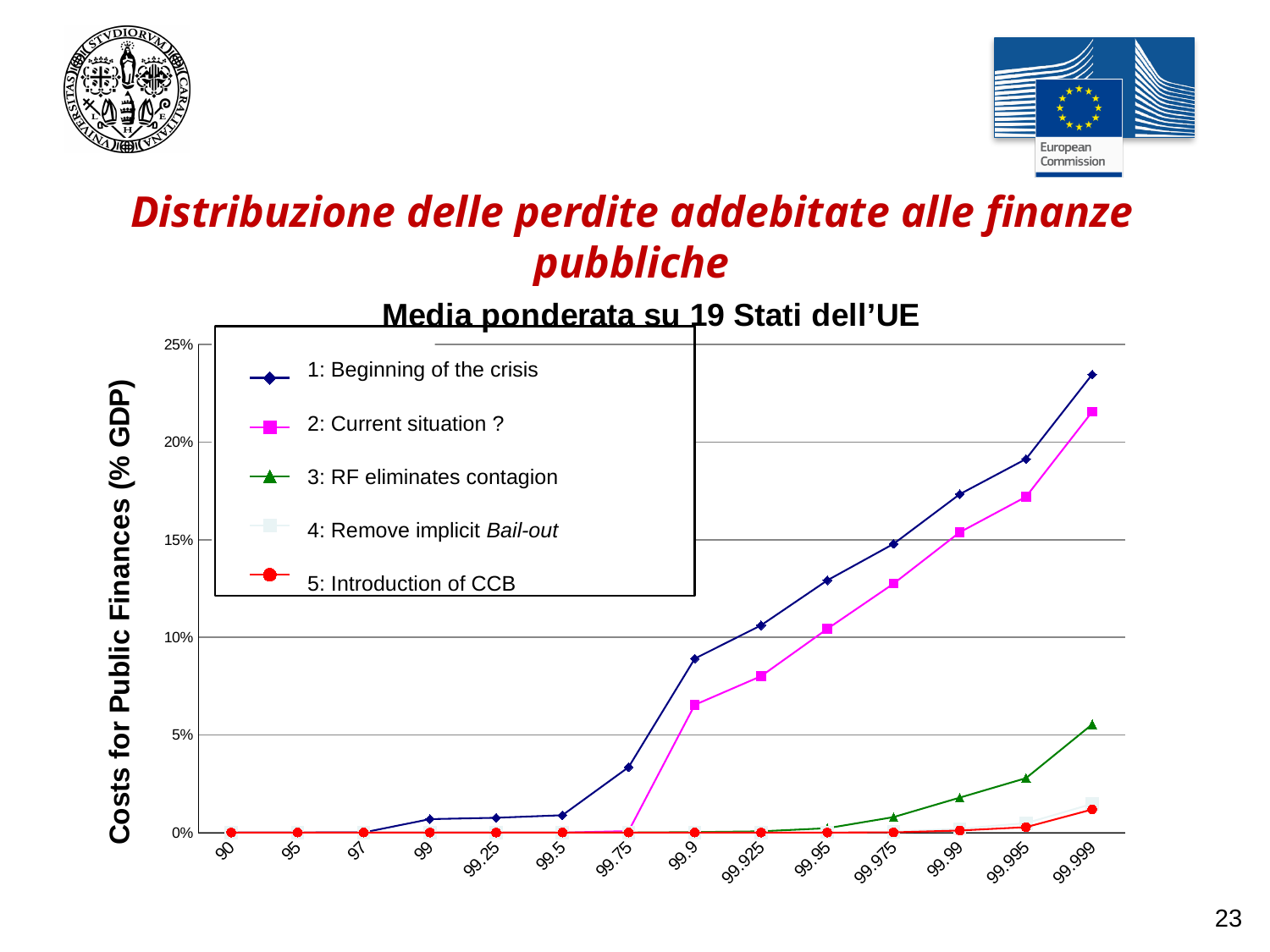
How many series does the chart legend list? 5 What is the label of the chart's vertical axis? Costs for Public Finances (% GDP) Is the value of '1: Beginning of the crisis' at 99.75 greater or less than 5%? less How many points are marked along the x axis of the chart? 14 What kind of chart is shown on the slide? line chart Does the '1: Beginning of the crisis' series rise or fall as you move from 90 to 99.999 along the x axis? rise What is the title printed above the chart? Media ponderata su 19 Stati dell'UE At 99.999, which is larger: '3: RF eliminates contagion' or '5: Introduction of CCB'? 3: RF eliminates contagion What is the value of '5: Introduction of CCB' at 90? 0% Which series has the highest value at 99.999? 1: Beginning of the crisis Is the value of '1: Beginning of the crisis' at 99.999 greater or less than 20%? greater Is the value of '3: RF eliminates contagion' at 99.999 greater or less than 10%? less